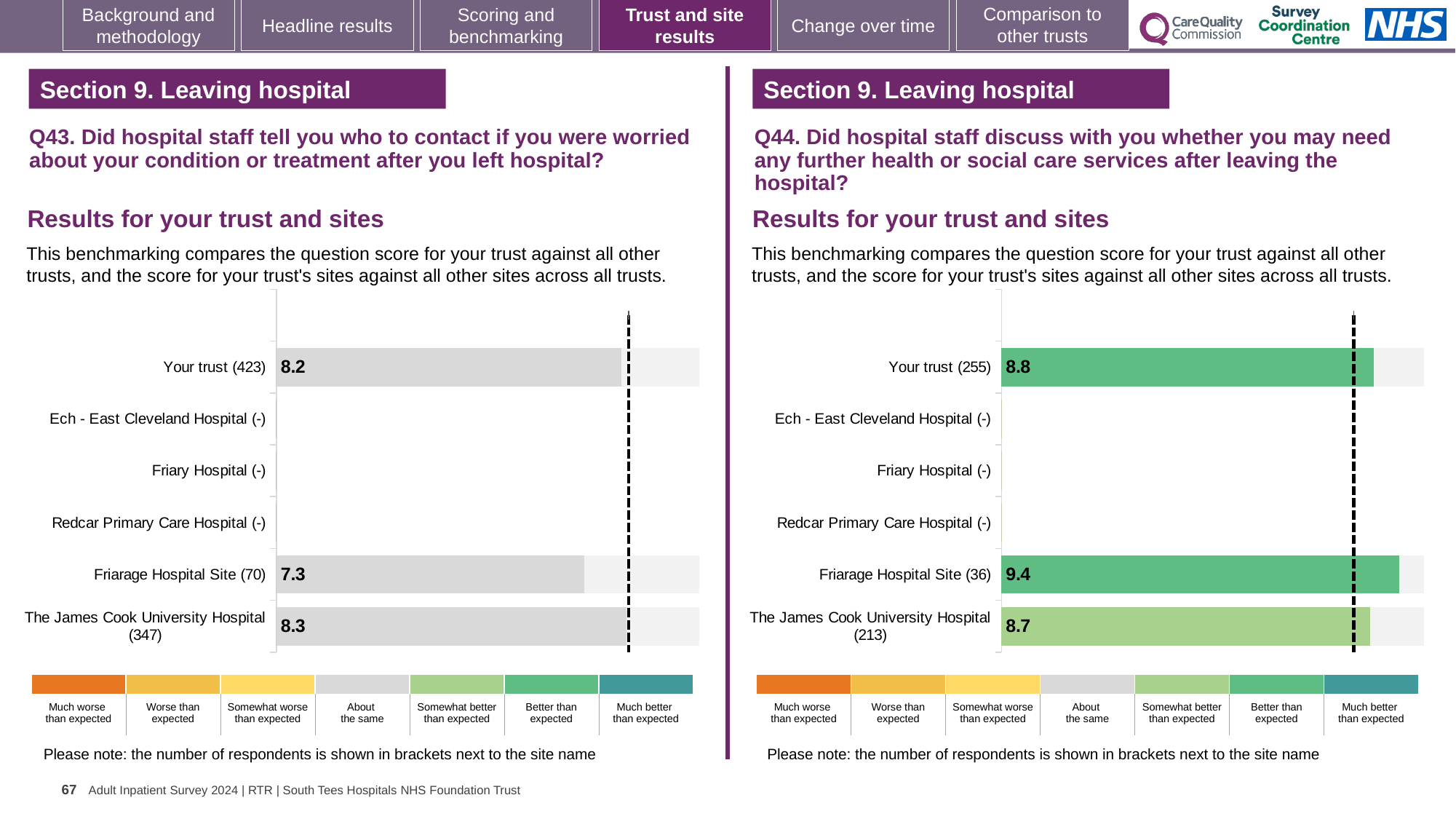
In the Q44 chart on the right, what is the difference between the scores for Friarage Hospital Site (36) and Your trust (255)? 0.6 In the Q44 chart on the right, what is the score for Friarage Hospital Site (36)? 9.4 In the Q43 chart on the left, what is the difference between the scores for The James Cook University Hospital (347) and Friarage Hospital Site (70)? 1.0 In the Q43 chart on the left, which site or trust row has the lowest score? Friarage Hospital Site (70) Which is larger: the Friarage Hospital Site score in the Q43 chart on the left or the Friarage Hospital Site score in the Q44 chart on the right? Q44 chart (9.4) In the Q43 chart on the left, what is the score for Your trust (423)? 8.2 In the Q43 chart on the left, what is the score for Friarage Hospital Site (70)? 7.3 What kind of chart is used in the Q43 chart on the left? Bar chart In the Q44 chart on the right, which row has the highest score? Friarage Hospital Site (36) In the Q43 chart on the left, what is the score for The James Cook University Hospital (347)? 8.3 In the Q44 chart on the right, what is the score for The James Cook University Hospital (213)? 8.7 In the Q44 chart on the right, what is the score for Your trust (255)? 8.8